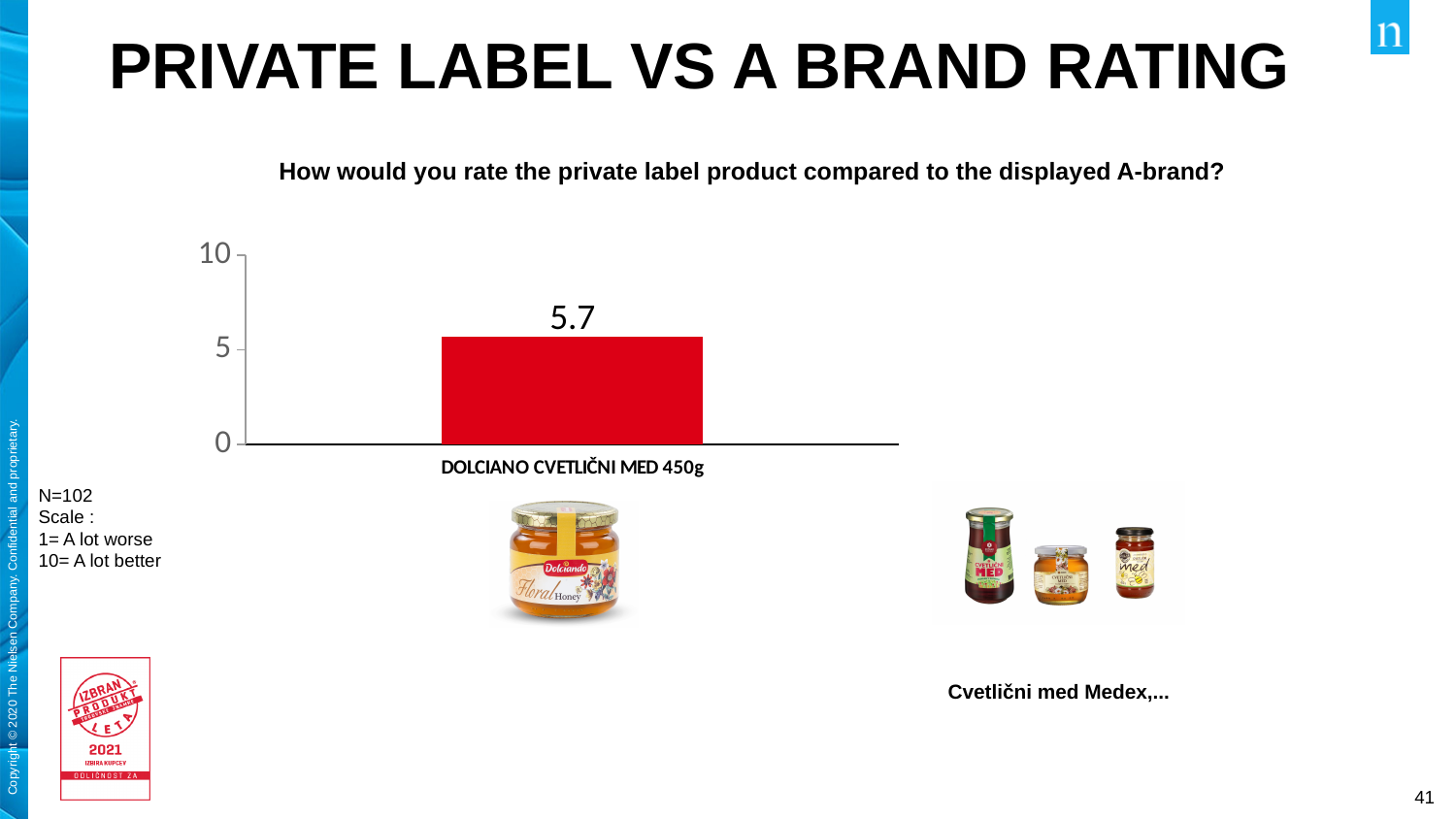
How many bars are plotted in the chart? 1 What kind of chart is shown on the slide? bar chart What is the sample size (N) stated next to the chart? N=102 What is the category label under the bar in the chart? DOLCIANO CVETLIČNI MED 450g Is the value for DOLCIANO CVETLIČNI MED 450g greater or less than 10? less What is the maximum value shown on the vertical axis of the chart? 10 Is the value for DOLCIANO CVETLIČNI MED 450g greater or less than 5? greater What is the rating value shown for DOLCIANO CVETLIČNI MED 450g? 5.7